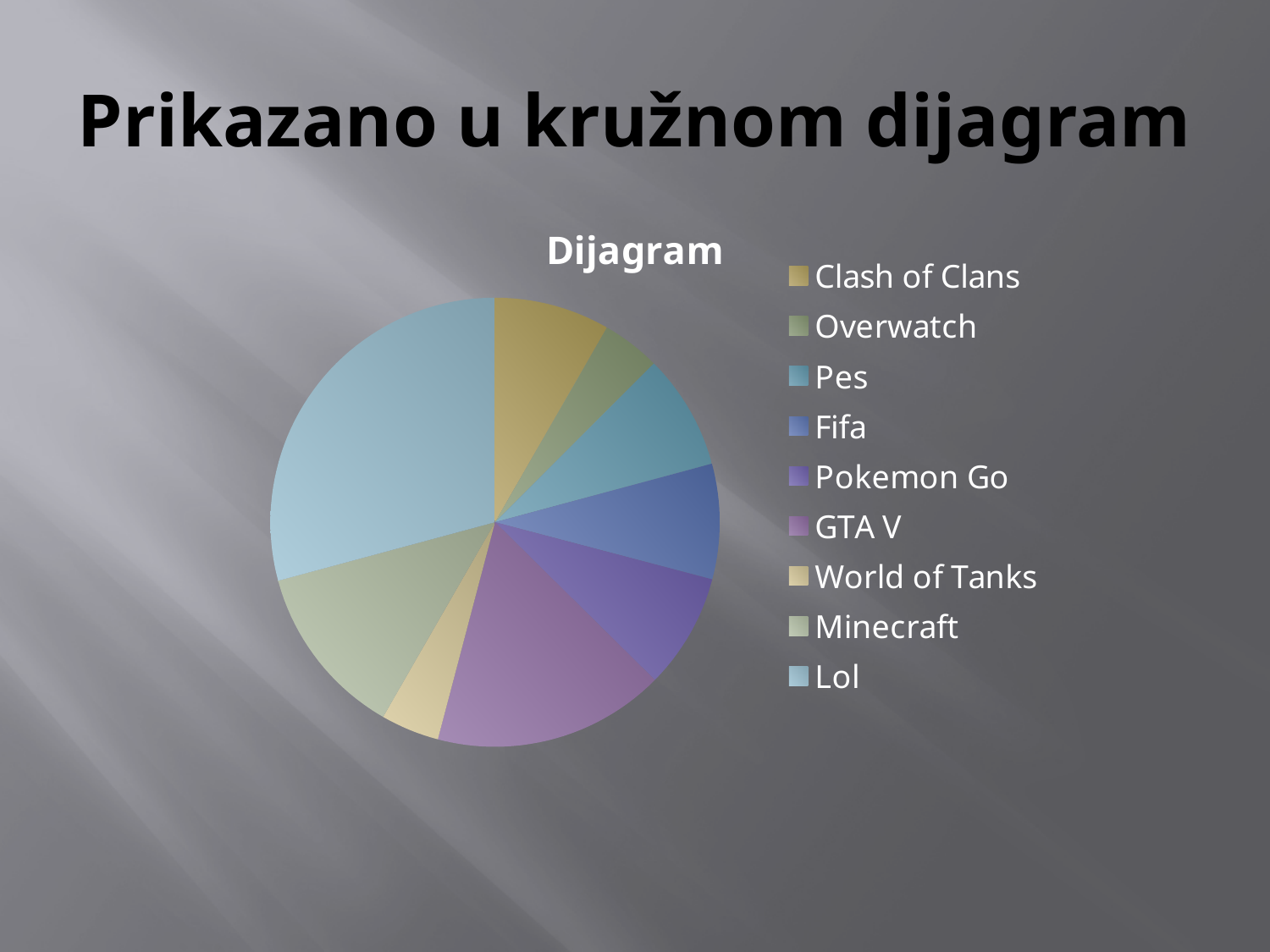
Which category is listed first in the legend? Clash of Clans Which category has the largest slice of the pie? Lol How many entries does the legend list? 9 What kind of chart is shown on the slide? pie chart What is the title of the chart? Dijagram Which slice is larger, Fifa or World of Tanks? Fifa How many categories (slices) does the pie chart have? 9 Which slice is larger, Minecraft or Overwatch? Minecraft Which slice is larger, Lol or GTA V? Lol